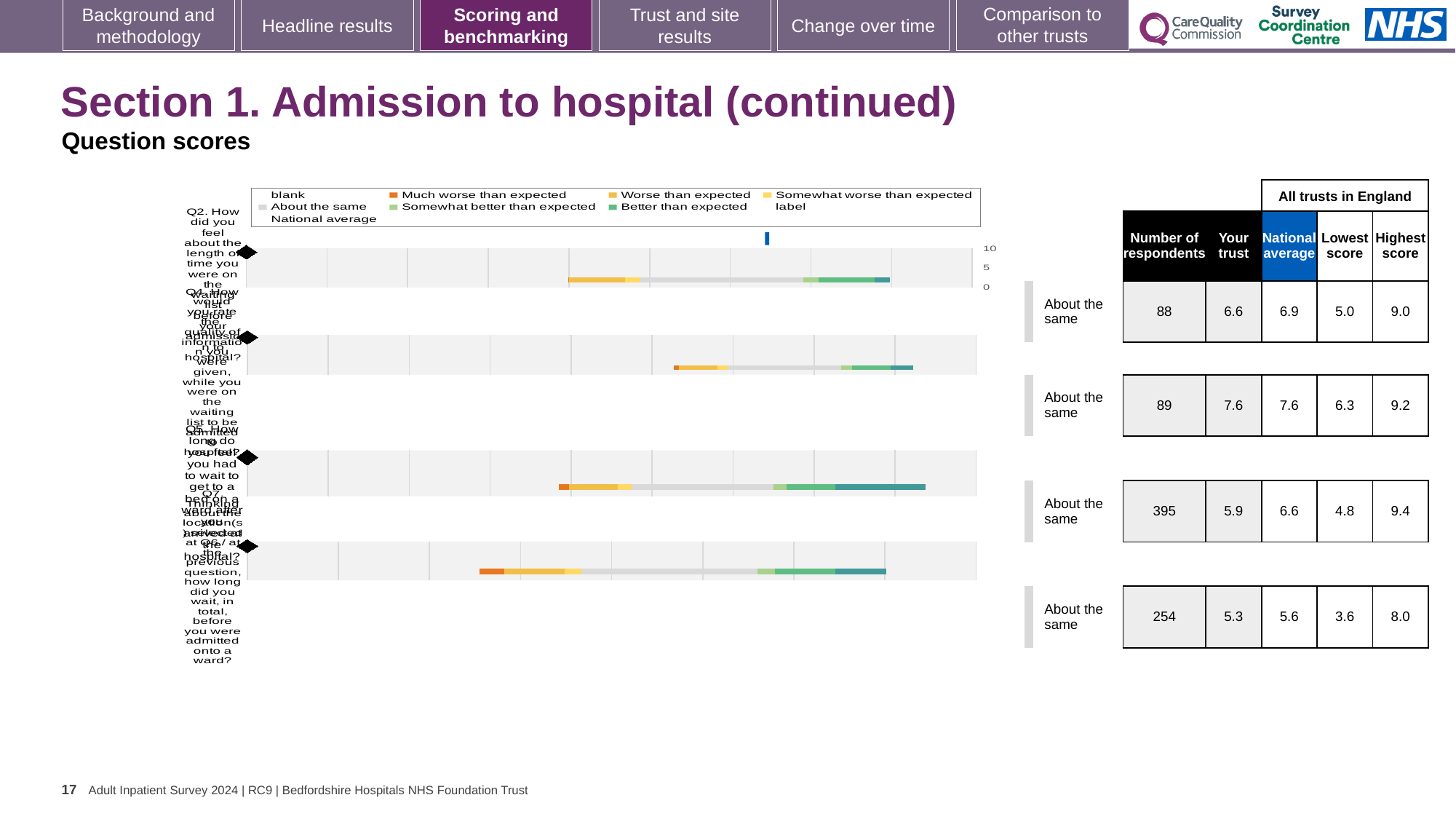
In the table beside the chart, which row has the highest number of respondents? Q5 (395) In the table beside the chart, what is the national average for the second row (Q4)? 7.6 What kind of chart is shown on the slide? bar chart In the table beside the chart, what is the 'Your trust' score for the top row (Q2)? 6.6 What colour does the legend use for 'Much worse than expected'? orange What is the heading above the chart on the slide? Question scores In the table beside the chart, how many respondents are listed for the third row (Q5)? 395 What benchmark category is shown for every question row on the slide? About the same In the table beside the chart, what is the highest score for the bottom row (Q7)? 8.0 In the table beside the chart, is the 'Your trust' score for the bottom row (Q7) greater or less than the national average? less In the table beside the chart, what is the difference between the national average and 'Your trust' score for the third row (Q5)? 0.7 How many question rows are plotted in the chart? 4